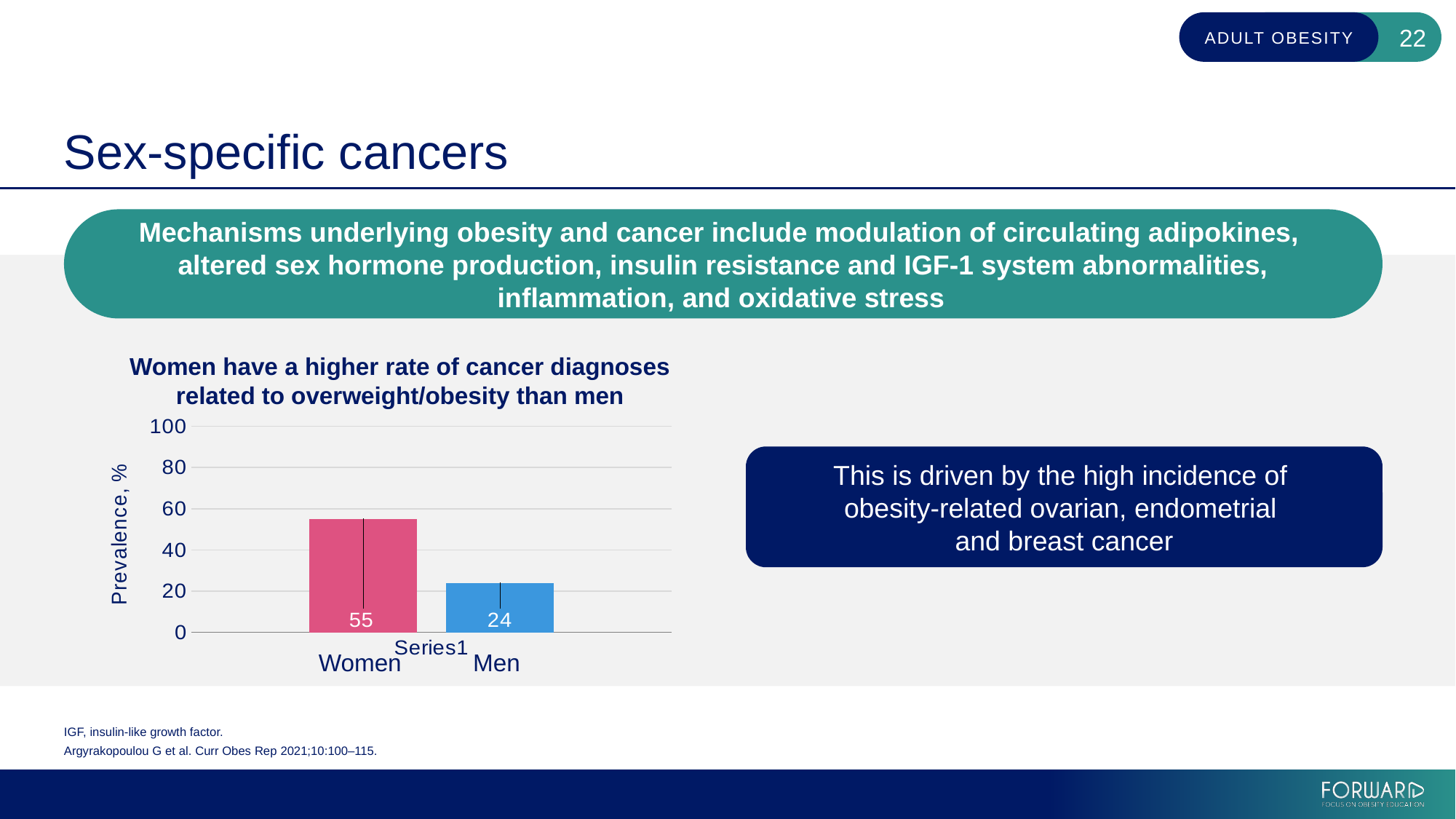
Is the value for Women greater or less than 40? greater What is the difference between the values for Women and Men? 31 What kind of chart is shown on the slide? Bar chart What is the title of the chart? Women have a higher rate of cancer diagnoses related to overweight/obesity than men What is the prevalence value shown for Men? 24 Which category has the highest value in the chart? Women Which group has the higher prevalence, Women or Men? Women What is the prevalence value shown for Women? 55 Which category has the lowest value in the chart? Men What is the label of the y axis of the chart? Prevalence, % Is the value for Men greater or less than 40? less How many bars are plotted in the chart? 2